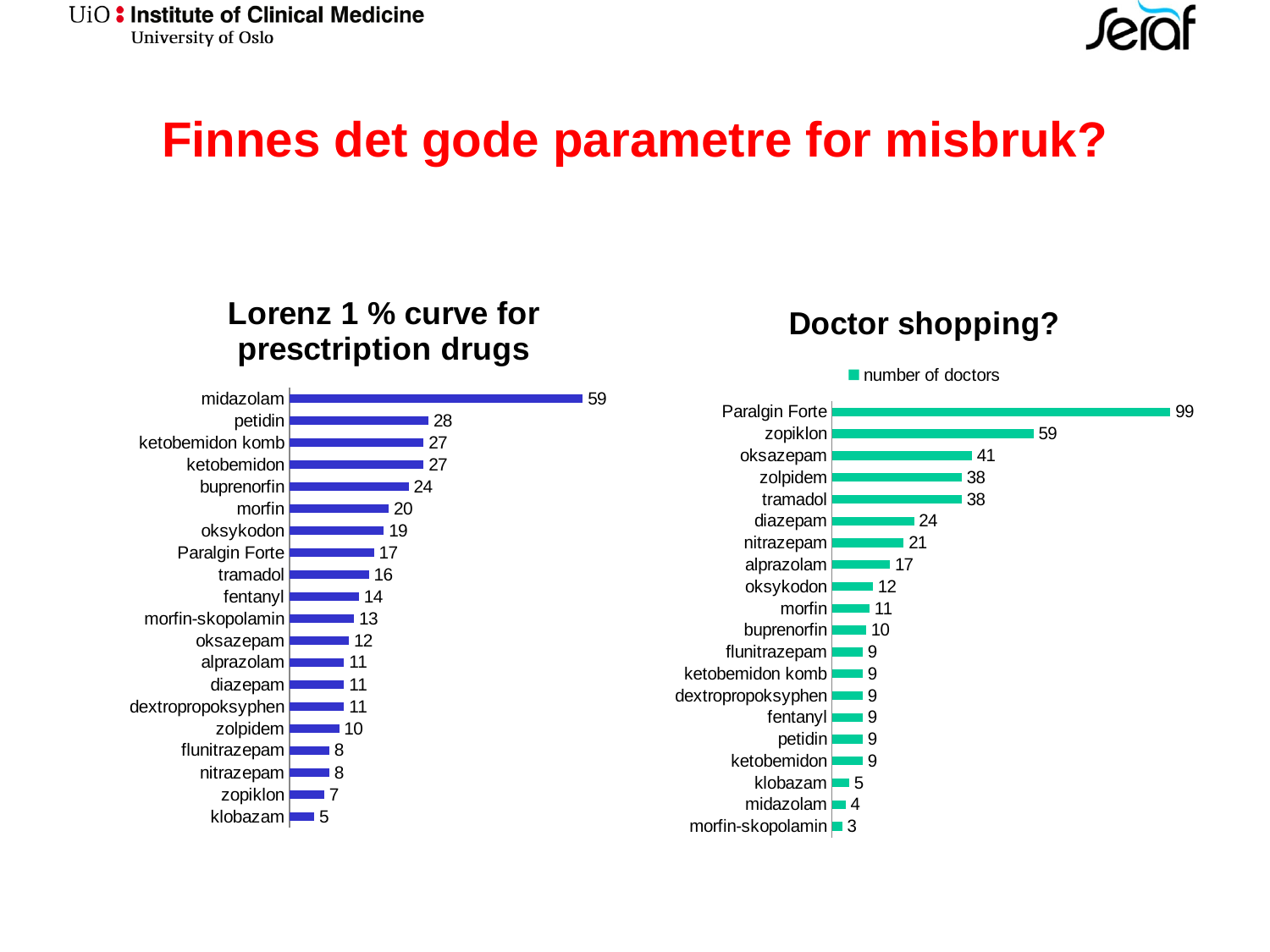
In the 'Lorenz 1 % curve for presctription drugs' chart, which category has the lowest value? klobazam In the 'Lorenz 1 % curve for presctription drugs' chart, which is larger, the value for petidin or the value for buprenorfin? petidin In the 'Doctor shopping?' chart, what is the difference between the values for oksazepam and zolpidem? 3 What kind of chart is the 'Lorenz 1 % curve for presctription drugs' chart? bar chart In the 'Lorenz 1 % curve for presctription drugs' chart, what is the value for Paralgin Forte? 17 What is the legend entry in the 'Doctor shopping?' chart? number of doctors In the 'Doctor shopping?' chart, which category has the highest value? Paralgin Forte In the 'Lorenz 1 % curve for presctription drugs' chart, what is the value for midazolam? 59 How many categories are shown in the 'Doctor shopping?' chart? 20 In the 'Doctor shopping?' chart, what is the difference between the values for Paralgin Forte and zopiklon? 40 How many series does the legend of the 'Doctor shopping?' chart list? 1 In the 'Doctor shopping?' chart, what is the value for zopiklon? 59